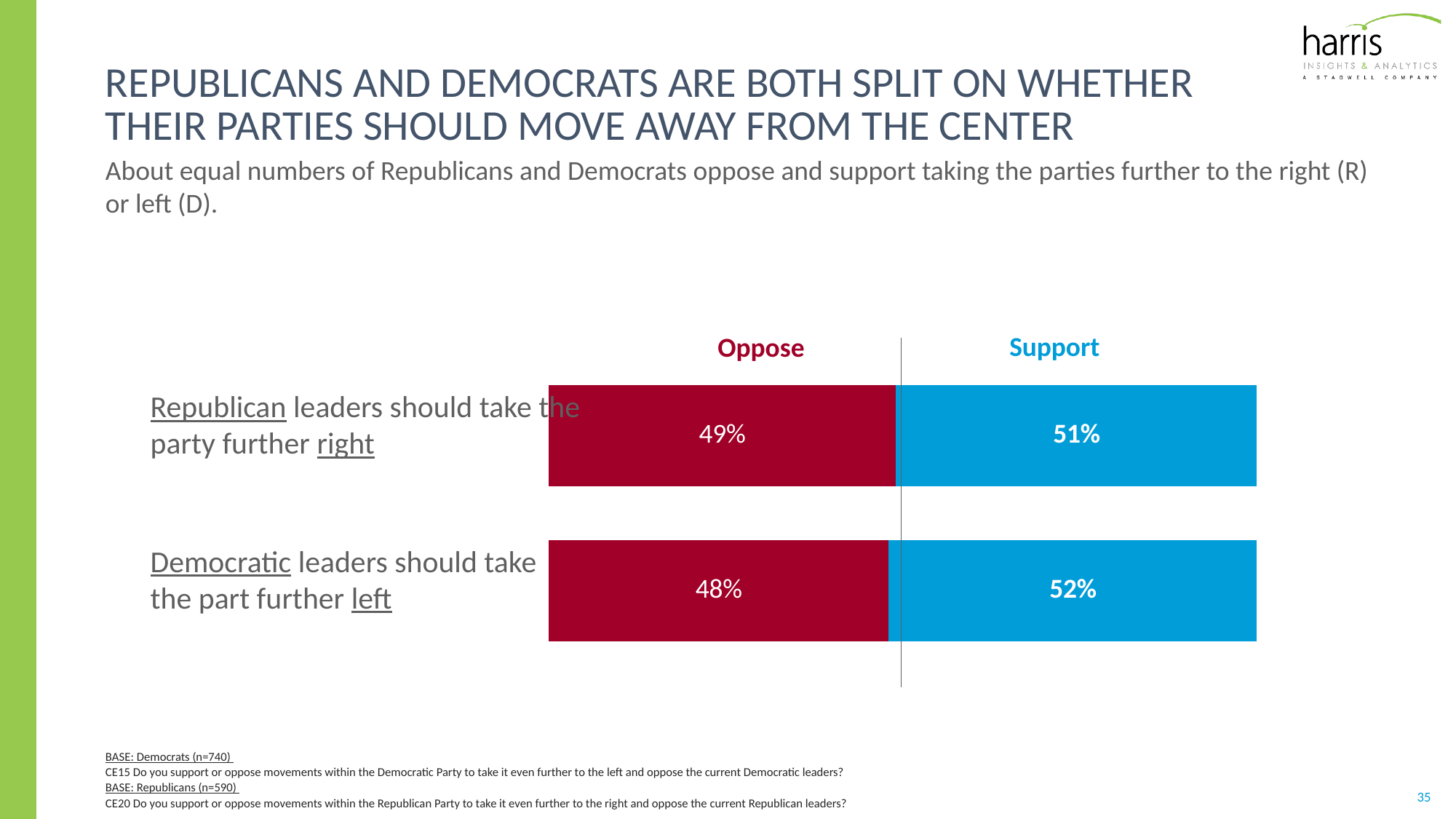
Which is larger for the Democratic statement, Oppose or Support? Support Which statement has the lower Oppose percentage? Democratic leaders should take the party further left What type of chart is shown on the slide? Bar chart What percentage oppose Democratic leaders taking the party further left? 48% What is the difference between the Support and Oppose percentages for the Republican statement? 2% What is the total of the Oppose and Support segments for the Republican statement? 100% How many statements (categories) are shown in the chart? 2 What percentage support Democratic leaders taking the party further left? 52% Which statement has the higher Support percentage? Democratic leaders should take the party further left What percentage support Republican leaders taking the party further right? 51% What is the difference between the Support and Oppose percentages for the Democratic statement? 4% What percentage oppose Republican leaders taking the party further right? 49%